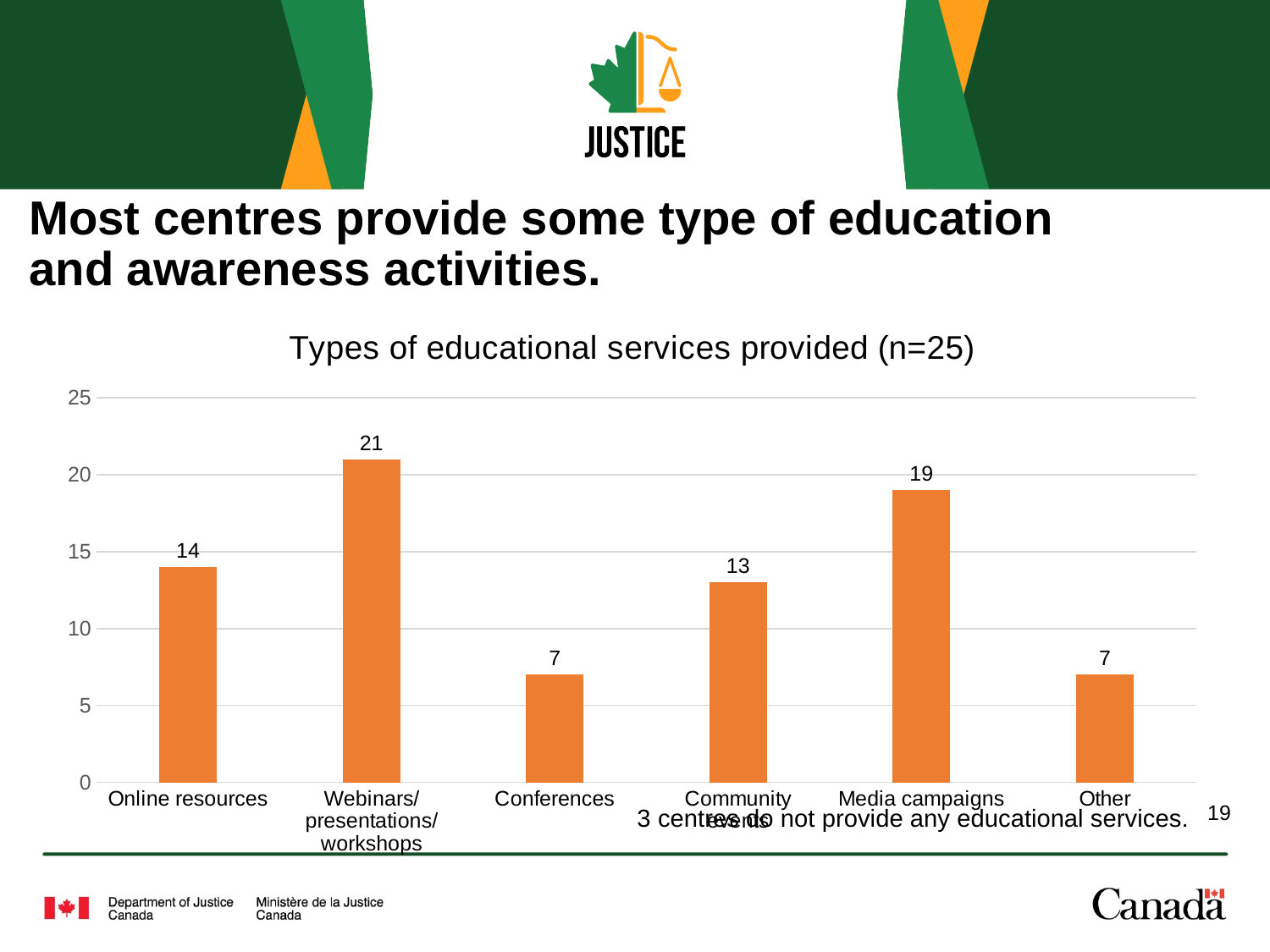
Which is larger, the value for Online resources or the value for Community events? Online resources What is the difference between the values for Webinars/presentations/workshops and Media campaigns? 2 What is the value for Media campaigns? 19 What is the value for Webinars/presentations/workshops? 21 What kind of chart is shown on the slide? Bar chart What is the value for Conferences? 7 What is the title of the chart? Types of educational services provided (n=25) Which category has the highest value? Webinars/presentations/workshops How many categories are shown in the chart? 6 Is the value for Media campaigns greater or less than 15? greater What is the value for Online resources? 14 What is the difference between the values for Online resources and Conferences? 7